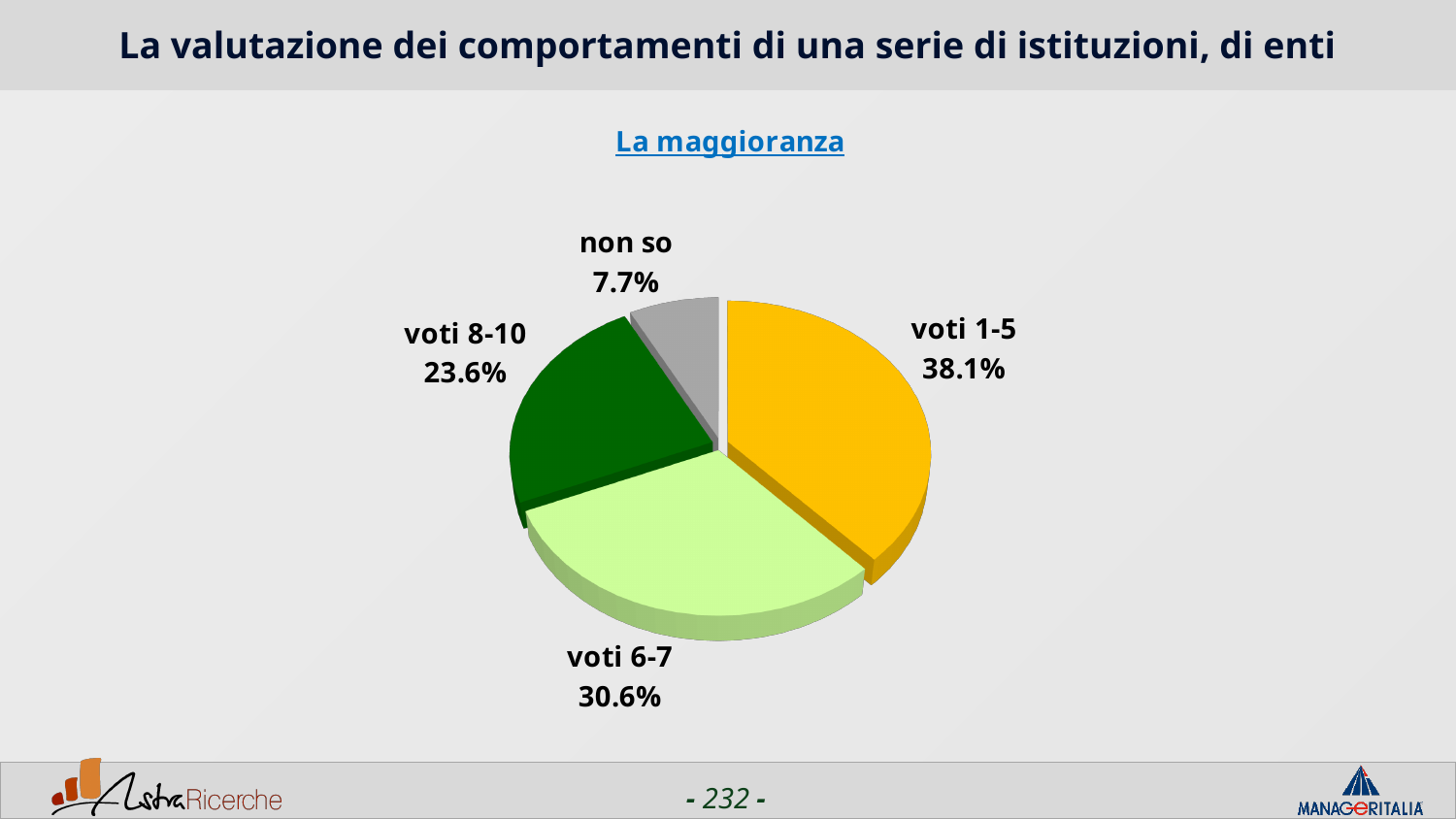
What is the share for 'voti 1-5'? 38.1% What is the share for 'voti 6-7'? 30.6% Which category has the largest slice of the pie? voti 1-5 What is the share for 'non so'? 7.7% Which is larger, the share for 'voti 6-7' or the share for 'voti 8-10'? voti 6-7 How many slices does the pie chart have? 4 What is the difference between the shares for 'voti 8-10' and 'non so'? 15.9% What is the difference between the shares for 'voti 1-5' and 'voti 6-7'? 7.5% What is the share for 'voti 8-10'? 23.6% What is the subtitle shown above the pie chart? La maggioranza Which category has the smallest slice of the pie? non so What kind of chart is shown on the slide? pie chart